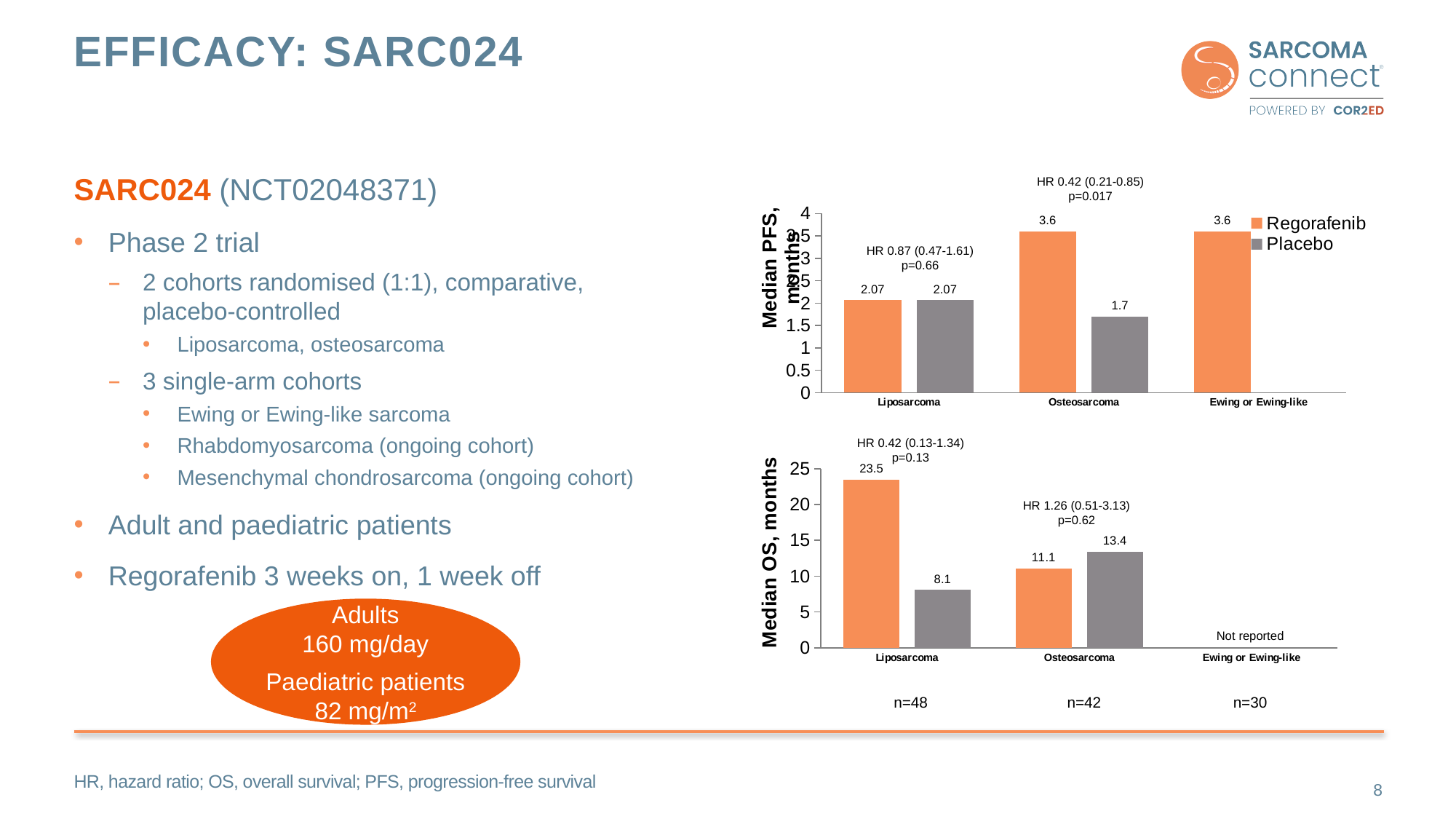
In the Median PFS chart, how many series does the legend list? 2 In the Median PFS chart, what is the difference between Regorafenib and Placebo in osteosarcoma? 1.9 In the Median PFS chart, what is the median PFS for Placebo in liposarcoma? 2.07 In the Median OS chart, what is shown for the Ewing or Ewing-like cohort? Not reported In the Median OS chart, what is the median OS for Placebo in osteosarcoma? 13.4 In the Median OS chart, what is the median OS for Regorafenib in liposarcoma? 23.5 In the Median OS chart, which is larger in osteosarcoma, Regorafenib or Placebo? Placebo In the Median OS chart, which bar has the highest value? Regorafenib, liposarcoma In the Median PFS chart, which colour represents Placebo? Grey In the Median PFS chart, what type of chart is shown? Bar chart In the Median OS chart, what is the difference between Regorafenib and Placebo in liposarcoma? 15.4 In the Median PFS chart, what is the median PFS for Regorafenib in osteosarcoma? 3.6